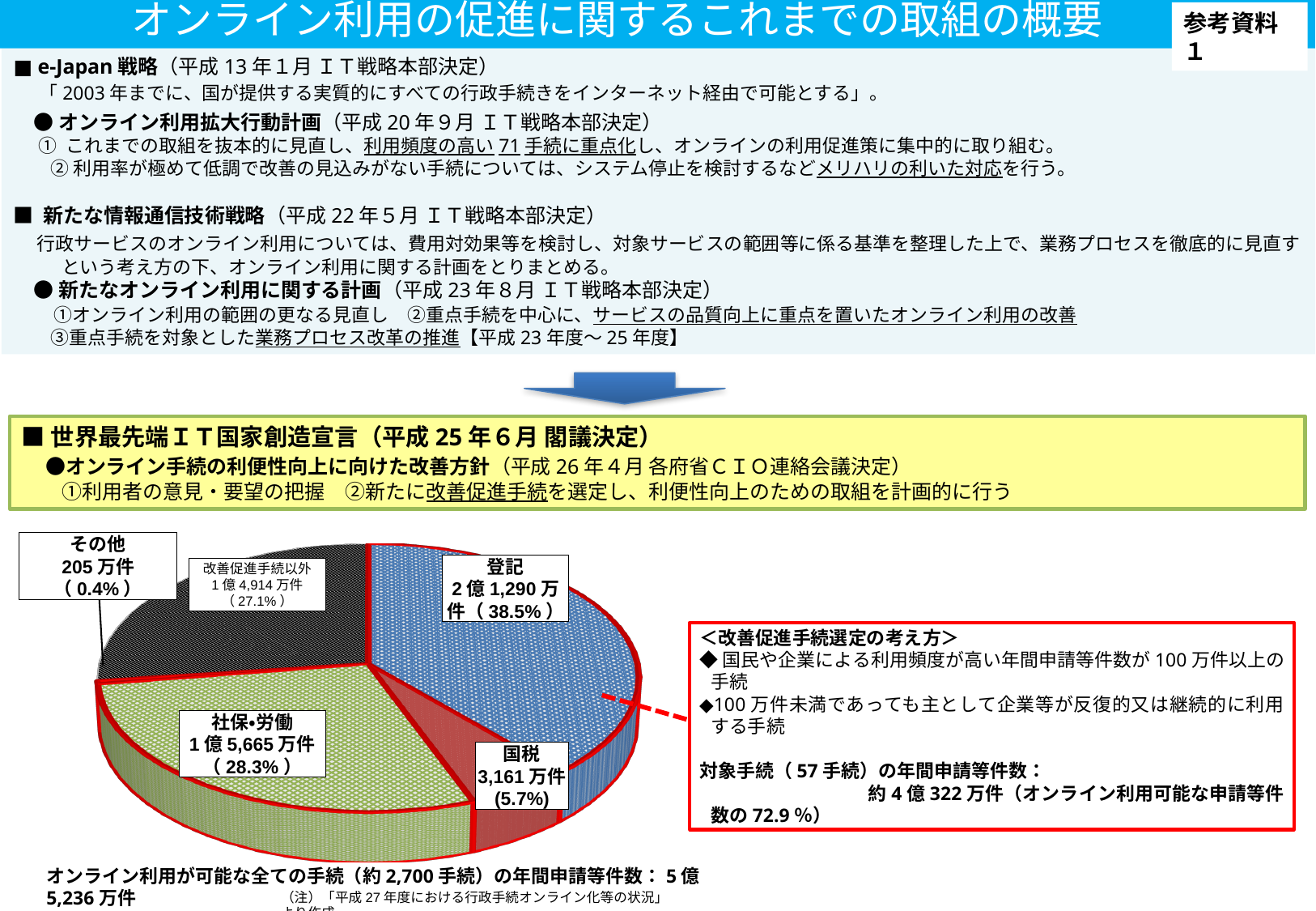
What share of the pie does the その他 slice represent? 0.4% Which slice of the pie chart is the smallest? その他 What kind of chart is shown at the bottom left of the slide? pie chart Which is larger in the pie chart, the share for 社保・労働 or the share for 国税? 社保・労働 What is the difference in percentage points between the 登記 share and the 社保・労働 share? 10.2 What is the number of cases shown for 国税 in the pie chart? 3,161万件 What share of the pie does the 登記 slice represent? 38.5% What is the number of cases shown for 社保・労働 in the pie chart? 1億5,665万件 What is the number of cases shown for 改善促進手続以外 in the pie chart? 1億4,914万件 What is the difference in percentage points between the 社保・労働 share and the 改善促進手続以外 share? 1.2 Which slice of the pie chart is the largest? 登記 How many slices does the pie chart have? 5